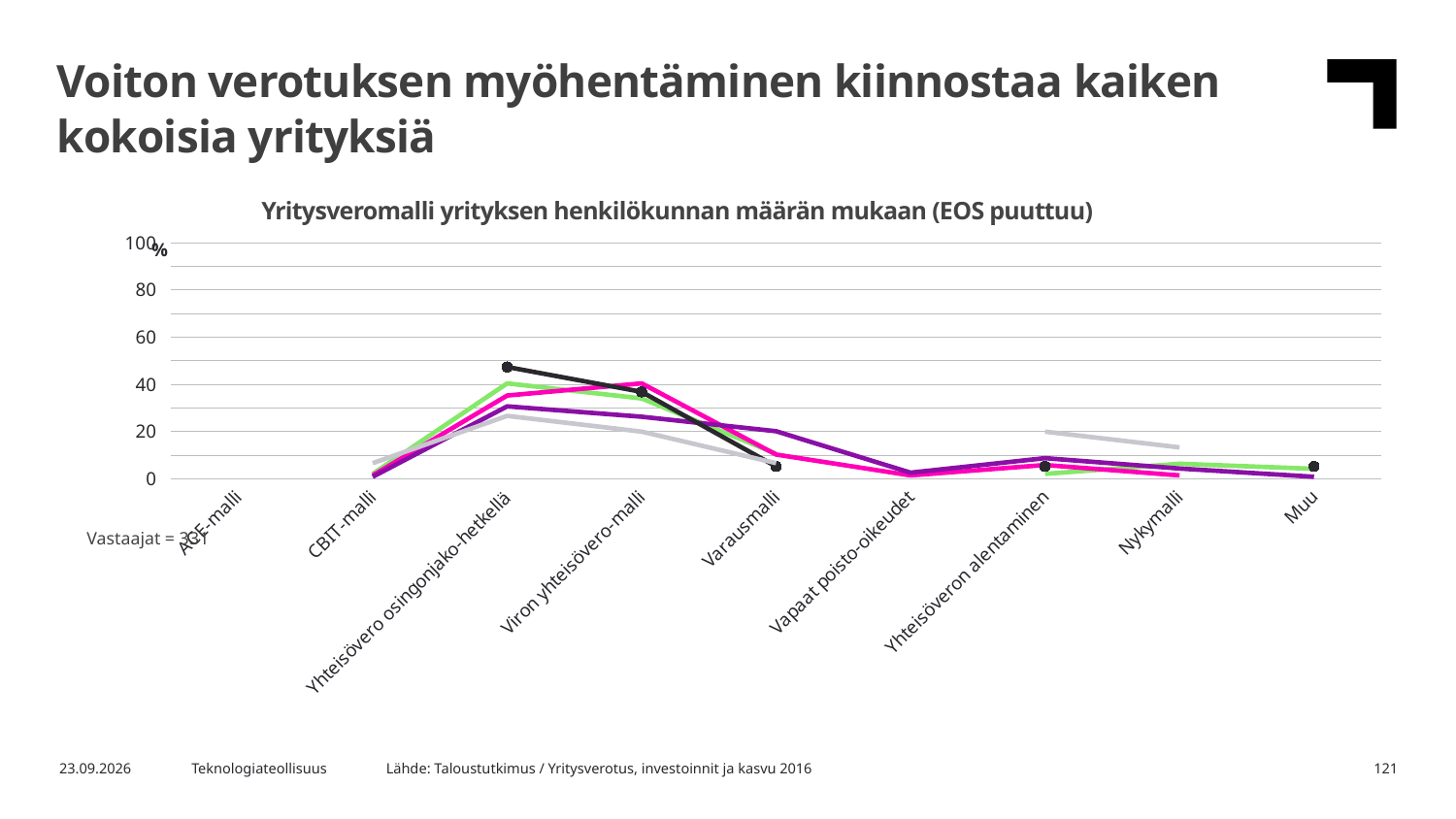
Are all the values at Vapaat poisto-oikeudet greater or less than 20? less What kind of chart is shown on the slide? line chart Is the highest value at Varausmalli greater or less than 40? less What is the title of the chart? Yritysveromalli yrityksen henkilökunnan määrän mukaan (EOS puuttuu) Are all the values at Nykymalli greater or less than 20? less Do the values rise or fall from CBIT-malli to Yhteisövero osingonjako-hetkellä? rise Do the values rise or fall from Viron yhteisövero-malli to Vapaat poisto-oikeudet? fall How many categories are shown on the x axis of the chart? 9 Which category has the highest plotted value in the chart? Yhteisövero osingonjako-hetkellä